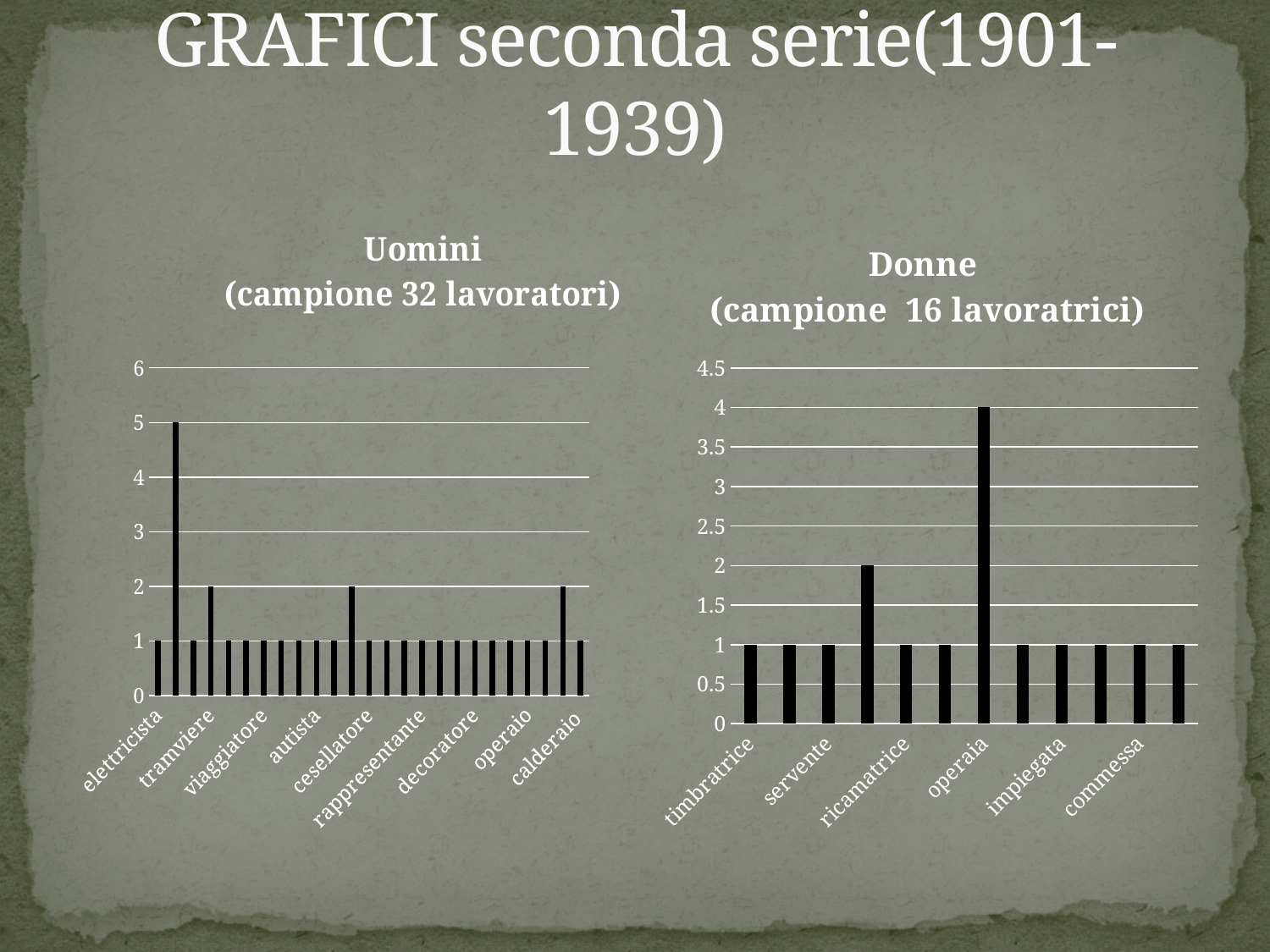
In the 'Donne (campione 16 lavoratrici)' chart, which category has the highest value? operaia In the 'Donne (campione 16 lavoratrici)' chart, what is the value for operaia? 4 In the 'Donne (campione 16 lavoratrici)' chart, how many bars are plotted? 12 What is the title of the chart on the right of the slide? Donne (campione 16 lavoratrici) What kind of chart is the 'Uomini (campione 32 lavoratori)' chart? bar chart In the 'Donne (campione 16 lavoratrici)' chart, what is the value for commessa? 1 In the 'Donne (campione 16 lavoratrici)' chart, which is larger, the value for operaia or the value for servente? operaia In the 'Donne (campione 16 lavoratrici)' chart, what is the value for timbratrice? 1 In the 'Uomini (campione 32 lavoratori)' chart, what is the value for elettricista? 1 In the 'Uomini (campione 32 lavoratori)' chart, what is the value of the tallest bar? 5 In the 'Uomini (campione 32 lavoratori)' chart, is the value of the tallest bar greater or less than 4? greater In the 'Donne (campione 16 lavoratrici)' chart, what is the difference between the values for operaia and commessa? 3